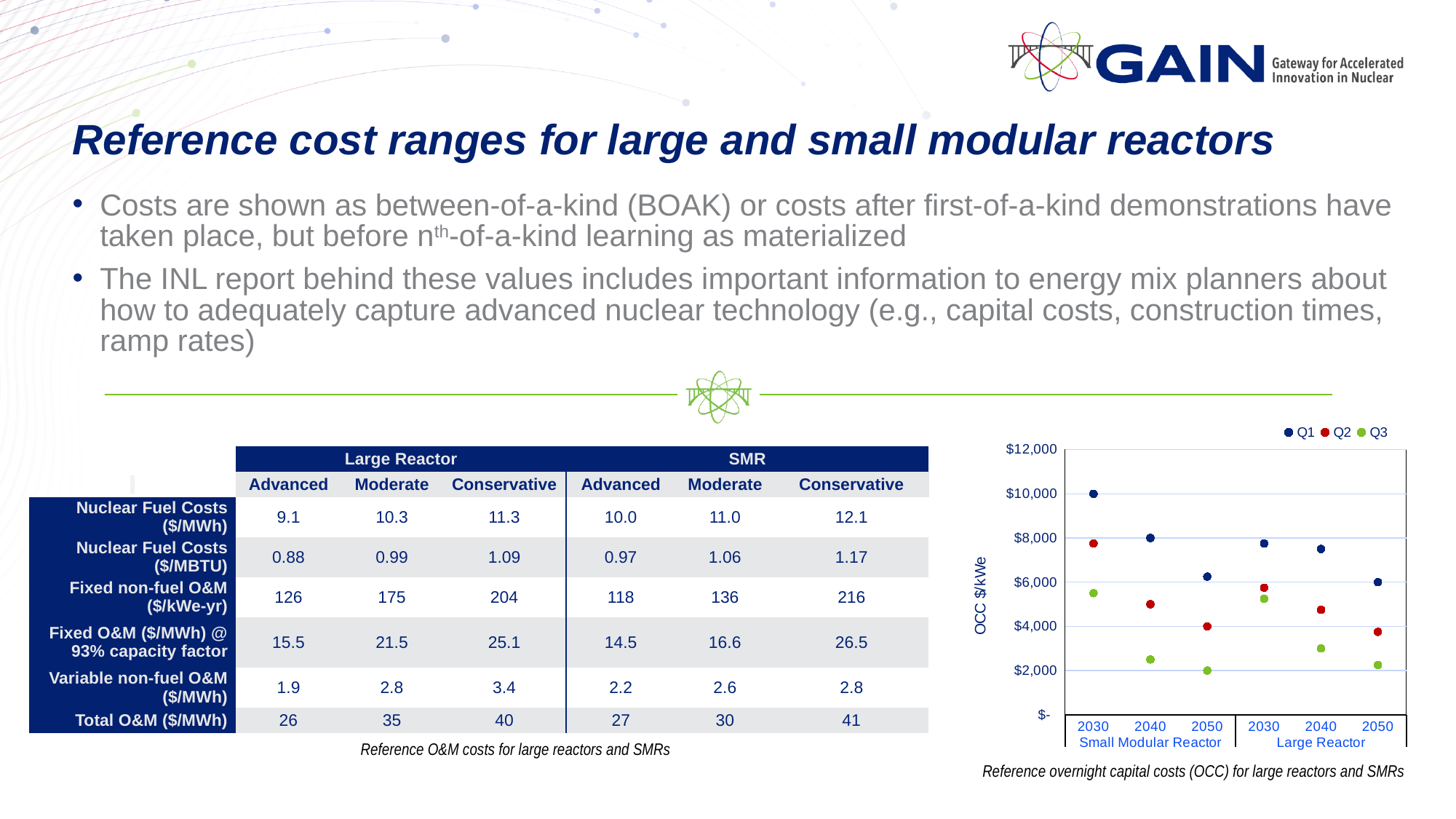
In the OCC chart, which point has the highest value overall? Q1, Small Modular Reactor 2030 In the OCC chart, which is larger: the Q1 value for Small Modular Reactor in 2030 or the Q1 value for Large Reactor in 2030? Small Modular Reactor 2030 In the OCC chart, is the Q3 value for Small Modular Reactor in 2030 greater or less than $4,000? greater In the OCC chart, what is the Q1 value for Small Modular Reactor in 2030? $10,000 In the OCC chart, what is the Q1 value for Small Modular Reactor in 2040? $8,000 In the OCC chart, is the Q2 value for Large Reactor in 2050 greater or less than $4,000? less What kind of chart is the chart on the right of the slide (Reference overnight capital costs)? Scatter (dot) chart In the OCC chart, how many series does the legend list? 3 In the OCC chart, how many year categories are shown along the x axis in total? 6 In the OCC chart, which point has the lowest value overall? Q3, Small Modular Reactor 2050 In the OCC chart, do the Q1 values for Small Modular Reactor rise or fall from 2030 to 2050? fall In the OCC chart, is the Q2 value for Small Modular Reactor in 2030 greater or less than $8,000? less